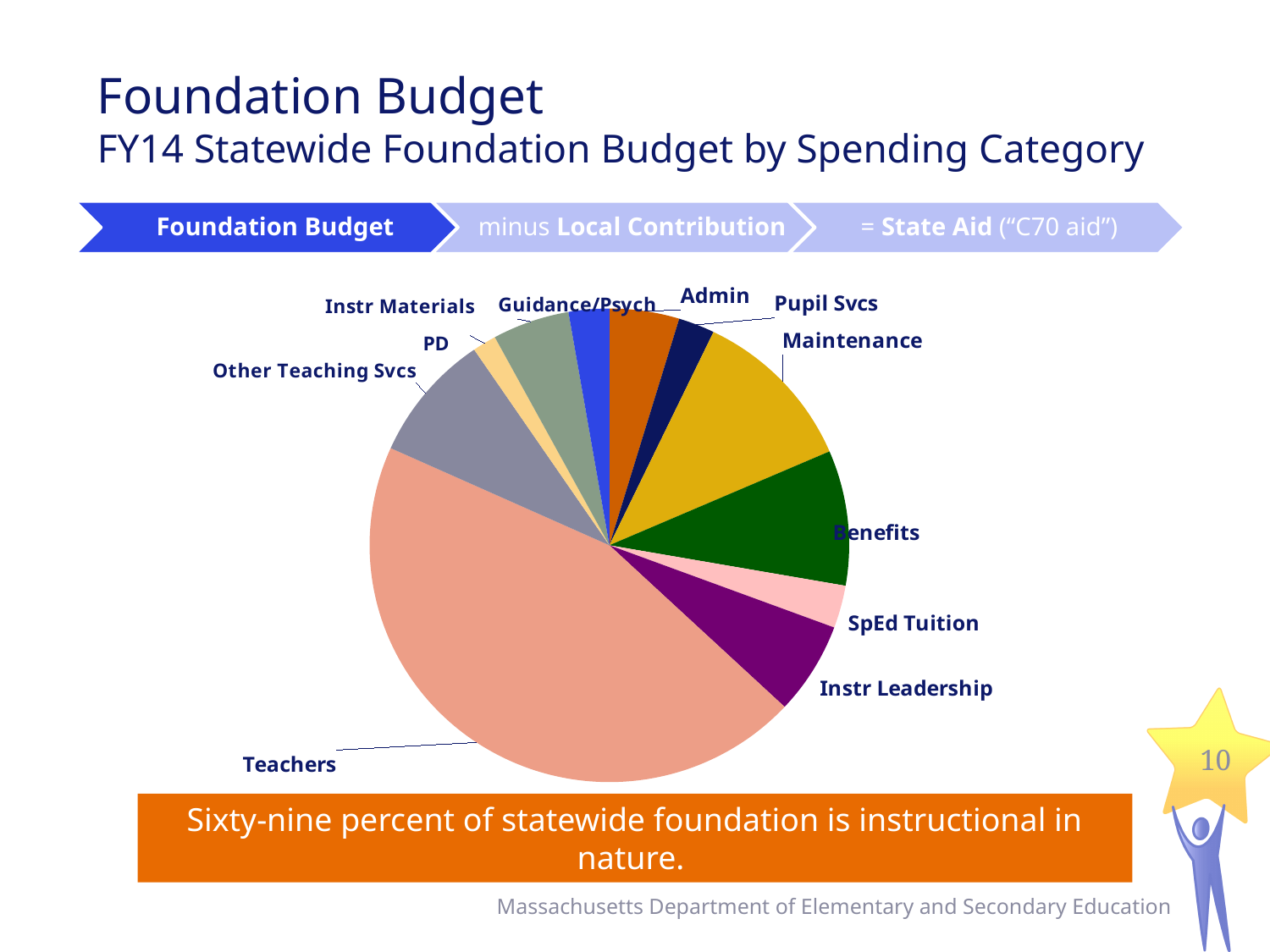
What kind of chart is shown on the slide? pie chart Which slice is larger, Teachers or Benefits? Teachers Which slice is larger, Benefits or Guidance/Psych? Benefits Which slice is larger, Instr Leadership or SpEd Tuition? Instr Leadership Which spending category has the largest slice of the pie chart? Teachers What is the subtitle describing the pie chart on the slide? FY14 Statewide Foundation Budget by Spending Category What colour is the Benefits slice of the pie chart? dark green How many spending categories (slices) does the pie chart show? 11